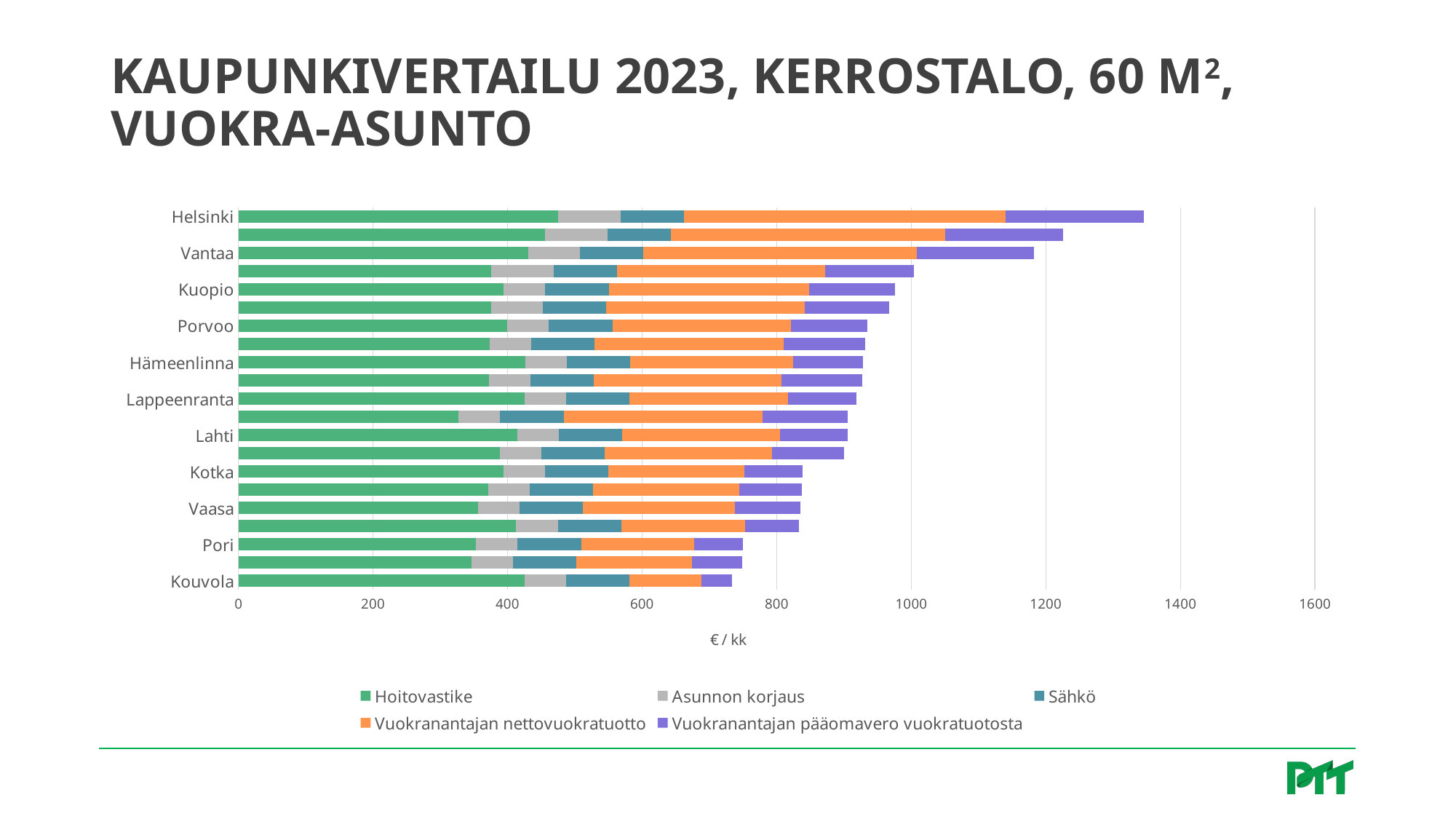
Is the total bar for Helsinki greater or less than 1200? greater What kind of chart is shown on the slide? Stacked bar chart Is the total bar for Vantaa greater or less than 1000? greater What is the label on the horizontal axis? € / kk Is the total bar for Kouvola greater or less than 800? less Which city has the longest total bar? Helsinki How many series does the legend list? 5 Do the total bar lengths increase or decrease going from Helsinki at the top to Kouvola at the bottom? decrease Which city has the shortest total bar? Kouvola Which has the longer total bar, Helsinki or Vantaa? Helsinki Which has the longer total bar, Hämeenlinna or Vaasa? Hämeenlinna